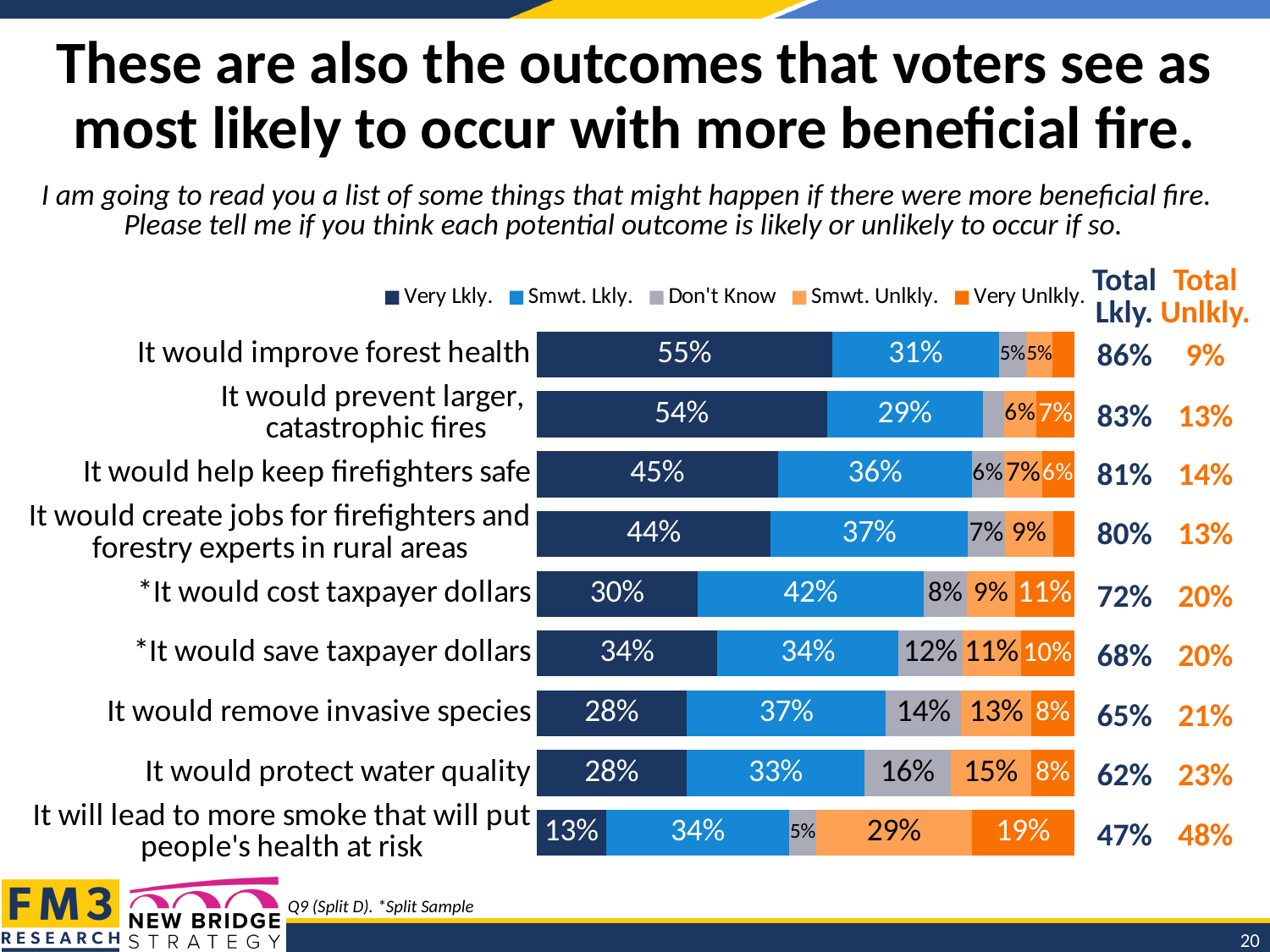
What percentage of voters said it is very likely that more beneficial fire would improve forest health? 55% What is the Total Lkly. figure for "It would protect water quality"? 62% What is the Very Unlkly. value for "It will lead to more smoke that will put people's health at risk"? 19% How many series does the legend list? 5 Which outcome has the lowest Very Lkly. value? It will lead to more smoke that will put people's health at risk Which is larger: the Very Lkly. value for "It would help keep firefighters safe" or for "It would create jobs for firefighters and forestry experts in rural areas"? It would help keep firefighters safe How many outcomes are listed in the chart? 9 What is the Smwt. Lkly. value for "It would cost taxpayer dollars"? 42% What is the difference between the Total Lkly. and Total Unlkly. figures for "It would remove invasive species"? 44% Which outcome has the highest Total Lkly. figure? It would improve forest health What is the Don't Know value for "It would save taxpayer dollars"? 12% What kind of chart is shown on the slide? Stacked bar chart